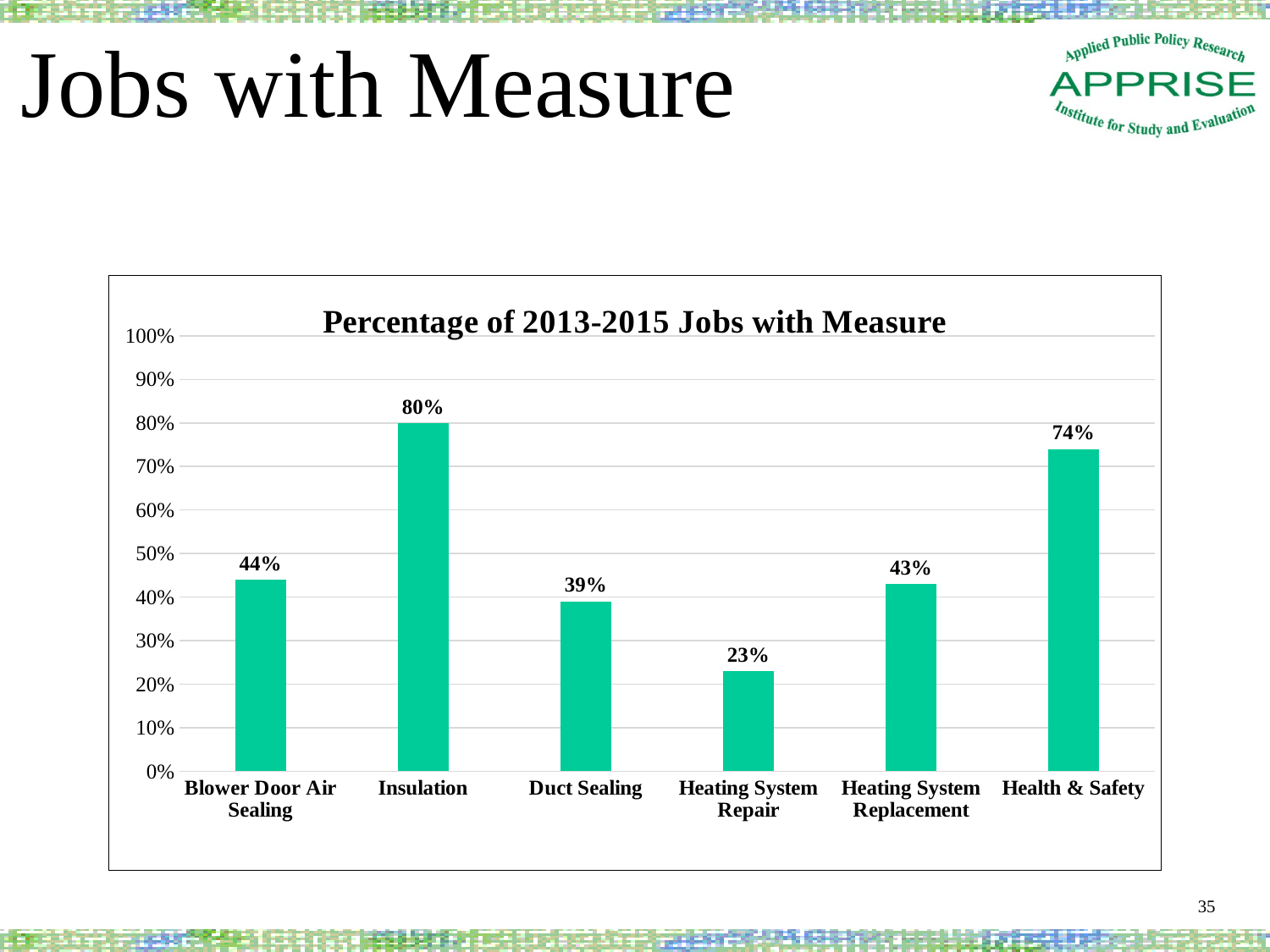
What is the title of the chart? Percentage of 2013-2015 Jobs with Measure What is the value shown for Heating System Repair? 23% What percentage of jobs included Health & Safety measures? 74% What percentage of 2013-2015 jobs included Insulation? 80% Is the value for Duct Sealing greater or less than 50%? less What is the difference between the percentages for Blower Door Air Sealing and Duct Sealing? 5% How many measure categories are shown on the chart? 6 What is the difference between the percentages for Insulation and Health & Safety? 6% Which has a higher percentage of jobs, Blower Door Air Sealing or Heating System Replacement? Blower Door Air Sealing What kind of chart is shown on the slide? Bar chart Which measure has the highest percentage of jobs? Insulation Which measure has the lowest percentage of jobs? Heating System Repair